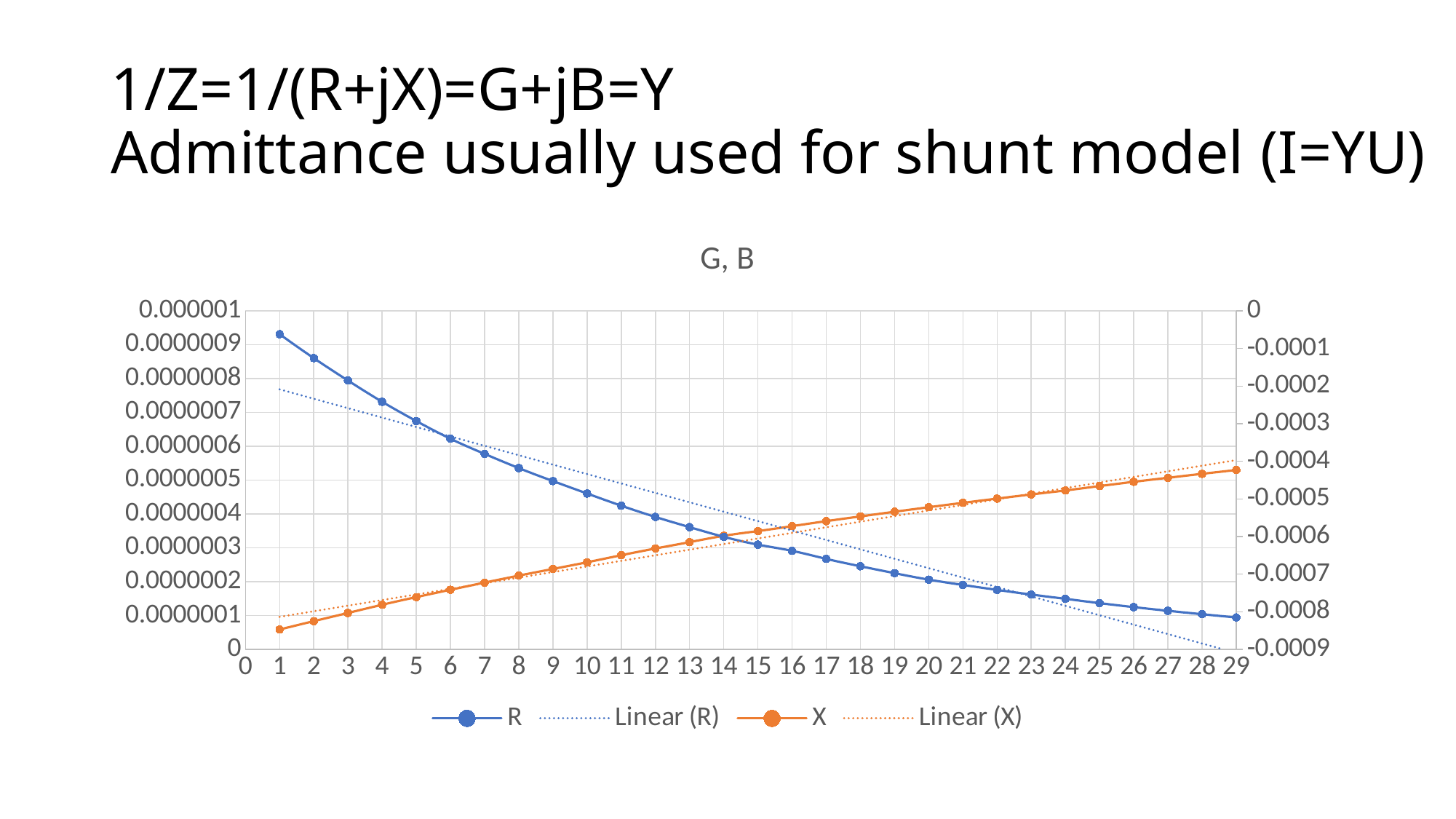
At which x value is the R series highest? 1 Which is larger for the R series: the value at x = 5 or the value at x = 20? x = 5 Do the values of the X series rise or fall as the x axis increases? rise What are the entries listed in the chart legend? R, Linear (R), X, Linear (X) How many data points are plotted for the R series? 29 What kind of chart is shown on the slide? line chart How many entries does the chart legend list? 4 At which x value is the R series lowest? 29 Is the value of the R series at x = 1 greater or less than 0.0000009 on the left axis? greater Do the values of the R series rise or fall as the x axis increases? fall What is the title of the chart? G, B